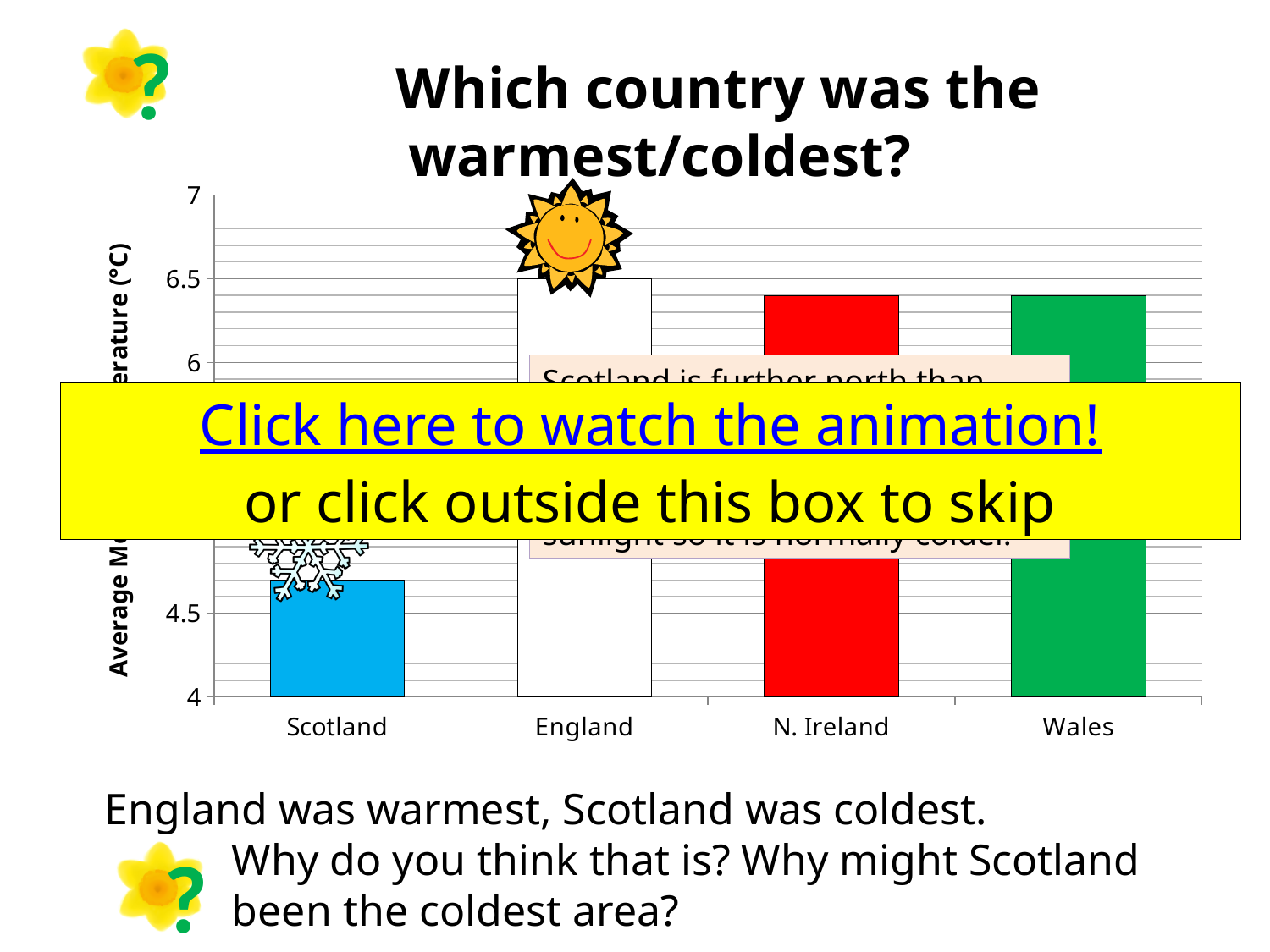
How many countries are shown on the x axis of the chart? 4 Which has the larger value, Scotland or Wales? Wales Which has the larger value, Scotland or England? England What is the title of the chart? Which country was the warmest/coldest? Is the value for N. Ireland greater or less than 6? greater Which country has the lowest bar in the chart? Scotland Which country has the highest bar in the chart? England What kind of chart is shown on the slide? bar chart Is the value for England greater or less than 6? greater Is the value for Wales greater or less than 6? greater What colour is the bar for Scotland? blue